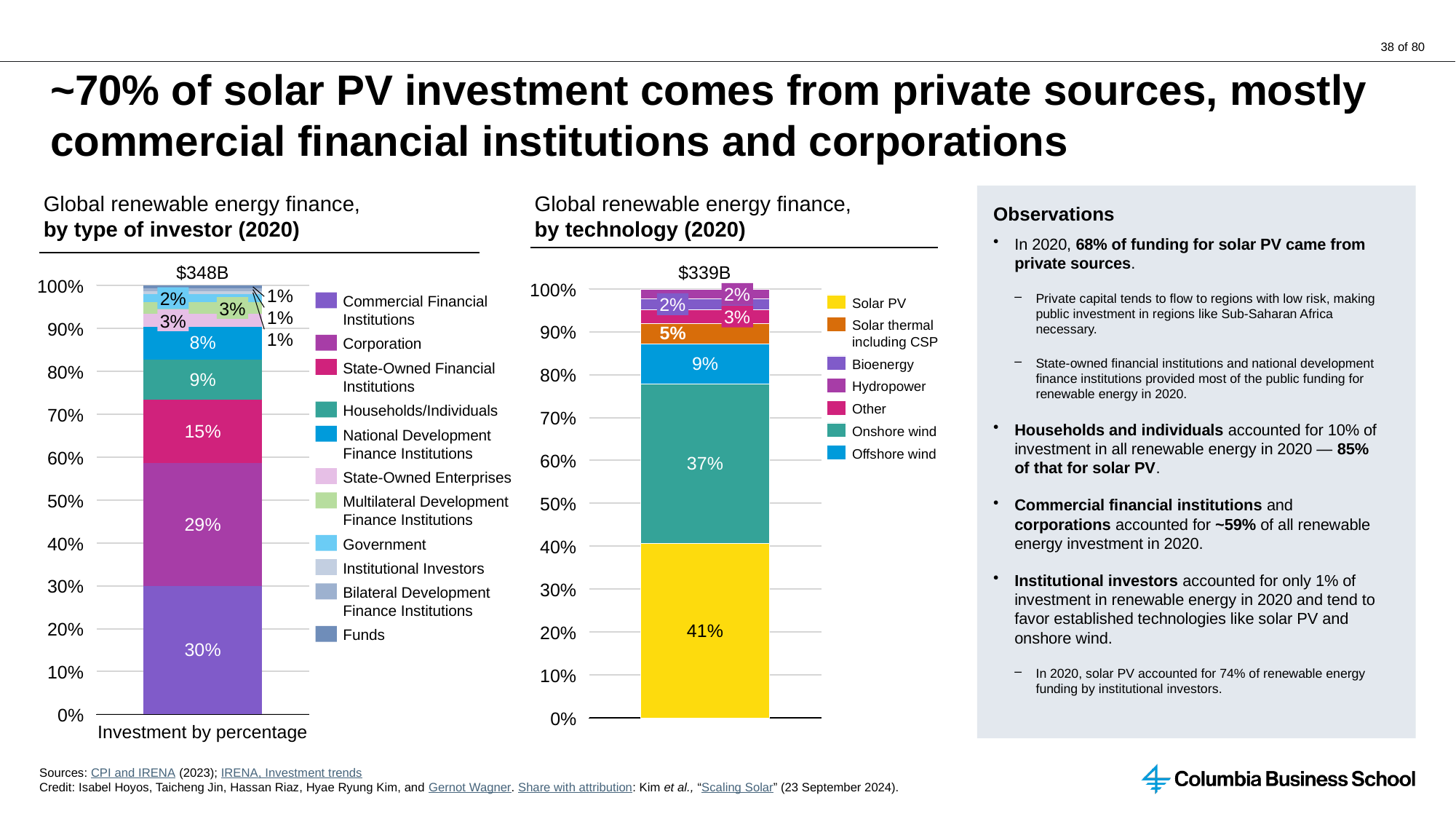
In the chart by type of investor (2020), what total dollar amount is shown above the bar? $348B How many investor types does the legend of the chart by type of investor (2020) list? 11 In the chart by type of investor (2020), what percentage of investment came from Commercial Financial Institutions? 30% In the chart by type of investor (2020), what is the difference between the Corporation share and the National Development Finance Institutions share? 21% In the chart by type of investor (2020), which type of investor has the largest share? Commercial Financial Institutions In the chart by technology (2020), which is larger: the share for Onshore wind or the share for Solar thermal including CSP? Onshore wind In the chart by type of investor (2020), what percentage of investment came from Households/Individuals? 9% In the chart by type of investor (2020), what percentage of investment came from State-Owned Financial Institutions? 15% What kind of chart is the chart by technology (2020)? Stacked bar chart In the chart by technology (2020), what percentage of investment went to Solar PV? 41% In the chart by technology (2020), what percentage of investment went to Offshore wind? 9% In the chart by technology (2020), what is the difference between the Solar PV share and the Onshore wind share? 4%